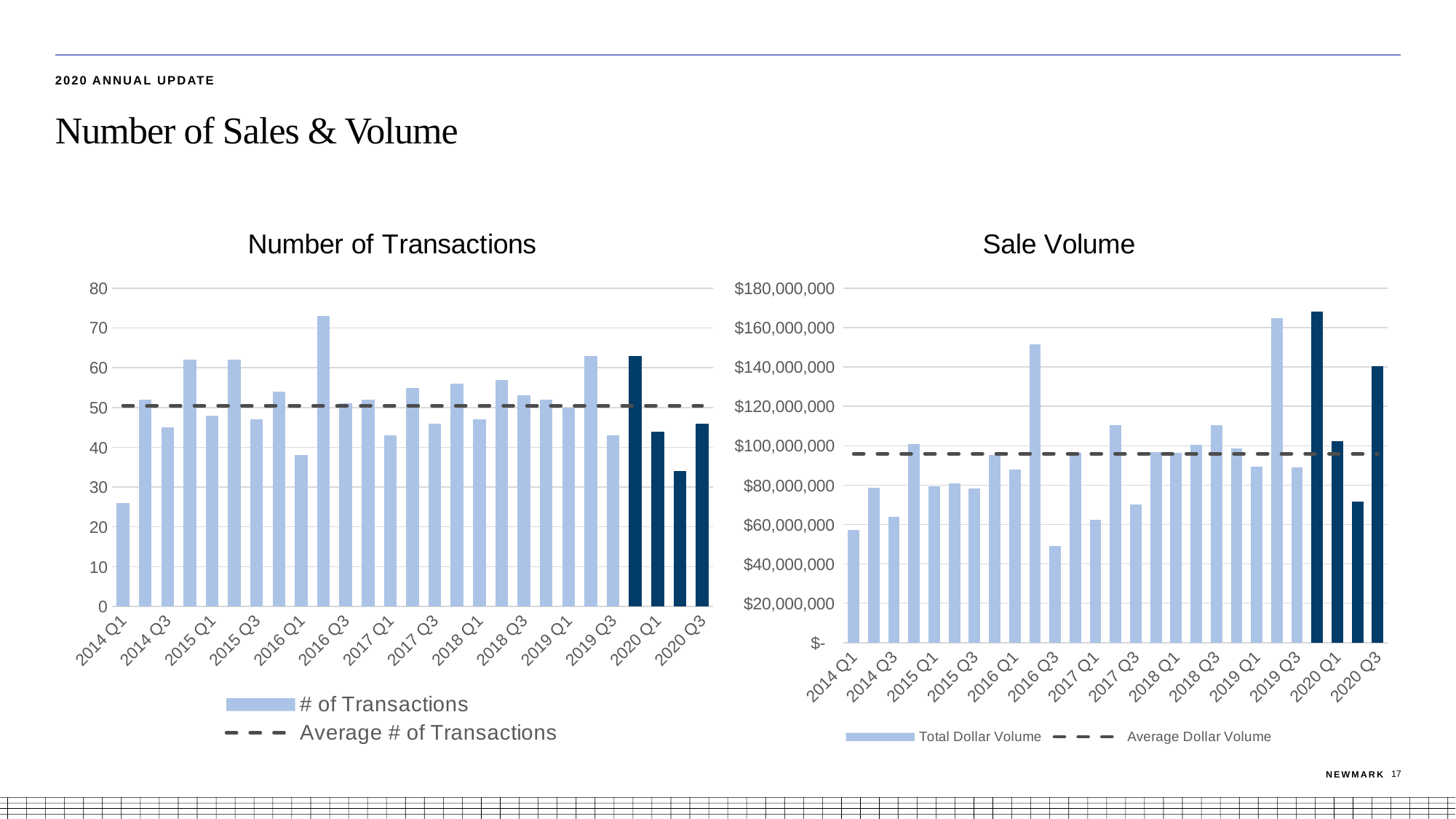
What kind of chart is the Sale Volume chart? bar chart In the Number of Transactions chart, is the value for 2014 Q1 greater or less than 30? less How many series does the legend of the Number of Transactions chart list? 2 In the Number of Transactions chart, which is larger, the value for 2014 Q1 or the value for 2020 Q1? 2020 Q1 In the Sale Volume chart, is the value for 2014 Q1 greater or less than $60,000,000? less How many series does the legend of the Sale Volume chart list? 2 In the Sale Volume chart, which is larger, the value for 2014 Q1 or the value for 2020 Q1? 2020 Q1 What kind of chart is the Number of Transactions chart? bar chart In the Sale Volume chart, is the value for 2020 Q1 greater or less than $160,000,000? less What are the two legend entries of the Sale Volume chart? Total Dollar Volume and Average Dollar Volume